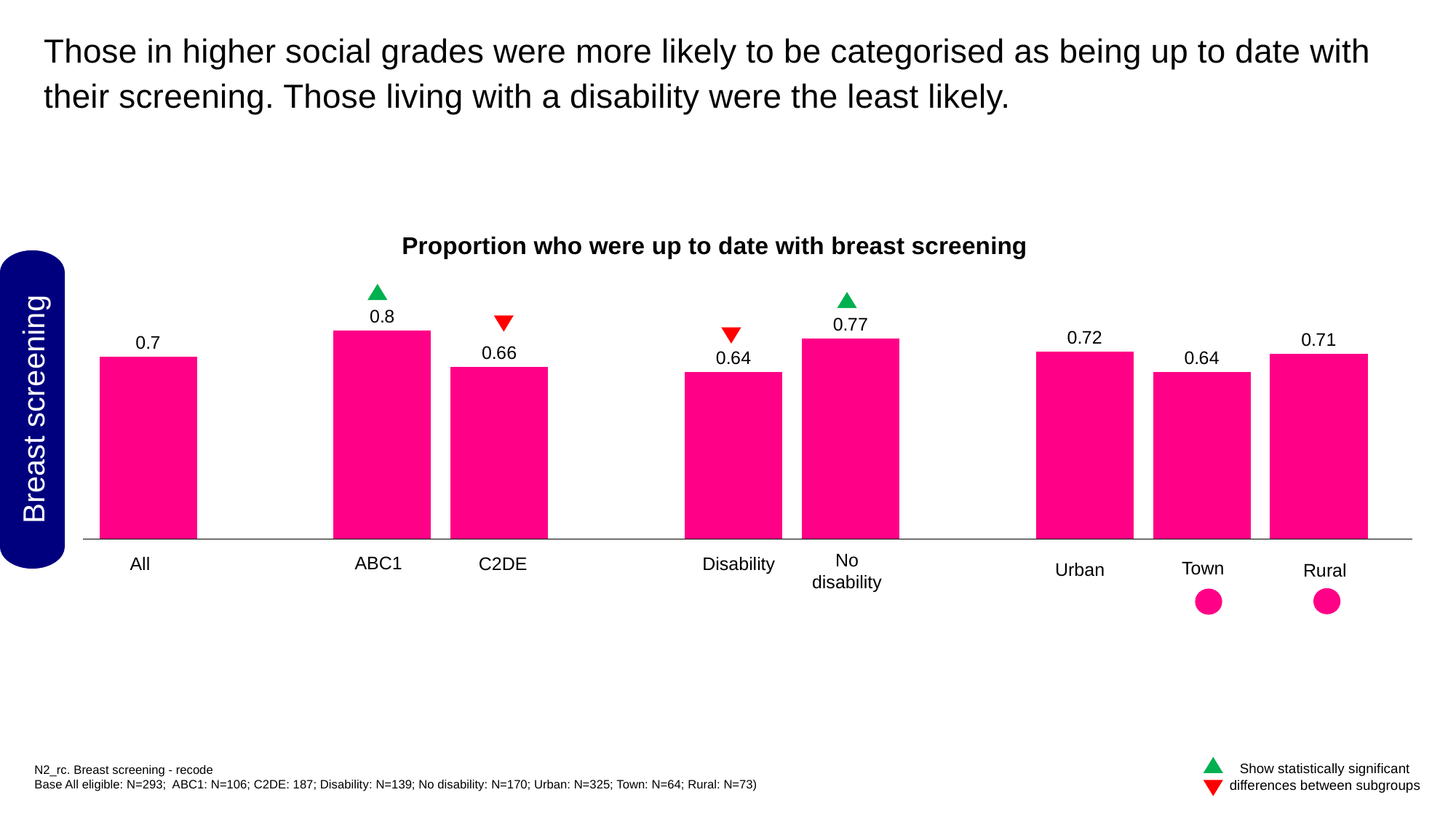
Which is larger, the value for Urban or the value for Town? Urban What kind of chart is shown on the slide? Bar chart What is the title of the chart? Proportion who were up to date with breast screening What is the difference between the values for ABC1 and C2DE? 0.14 What is the value for All? 0.7 Which category has the highest value? ABC1 Which is larger, the value for No disability or the value for All? No disability What is the value for Disability? 0.64 How many categories are shown on the chart? 8 What is the value for ABC1? 0.8 What is the value for Rural? 0.71 What is the difference between the values for No disability and Disability? 0.13